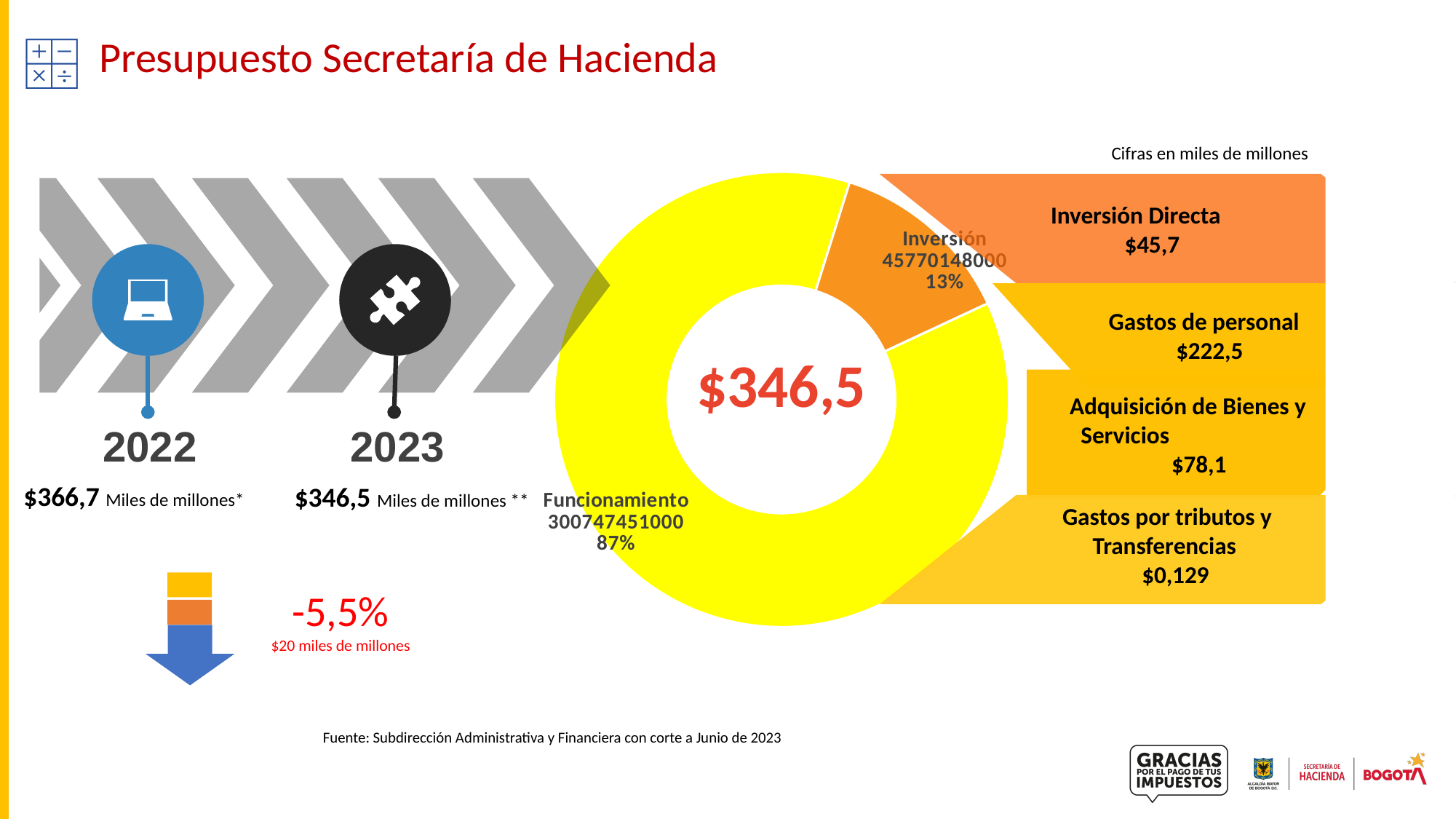
What total value is printed in the centre of the donut chart? $346,5 Which slice of the donut chart is the smallest? Inversión Which slice of the donut chart is the largest? Funcionamiento What kind of chart is shown on the slide? Pie (donut) chart What value is printed for the Inversión slice? 45770148000 Which is larger, the Funcionamiento slice or the Inversión slice? Funcionamiento By how many percentage points does the Funcionamiento share exceed the Inversión share? 74 How many slices does the donut chart have? 2 What colour is the Funcionamiento slice of the donut chart? Yellow What percentage share does the Inversión slice represent? 13% What percentage share does the Funcionamiento slice represent? 87% What value is printed for the Funcionamiento slice? 300747451000